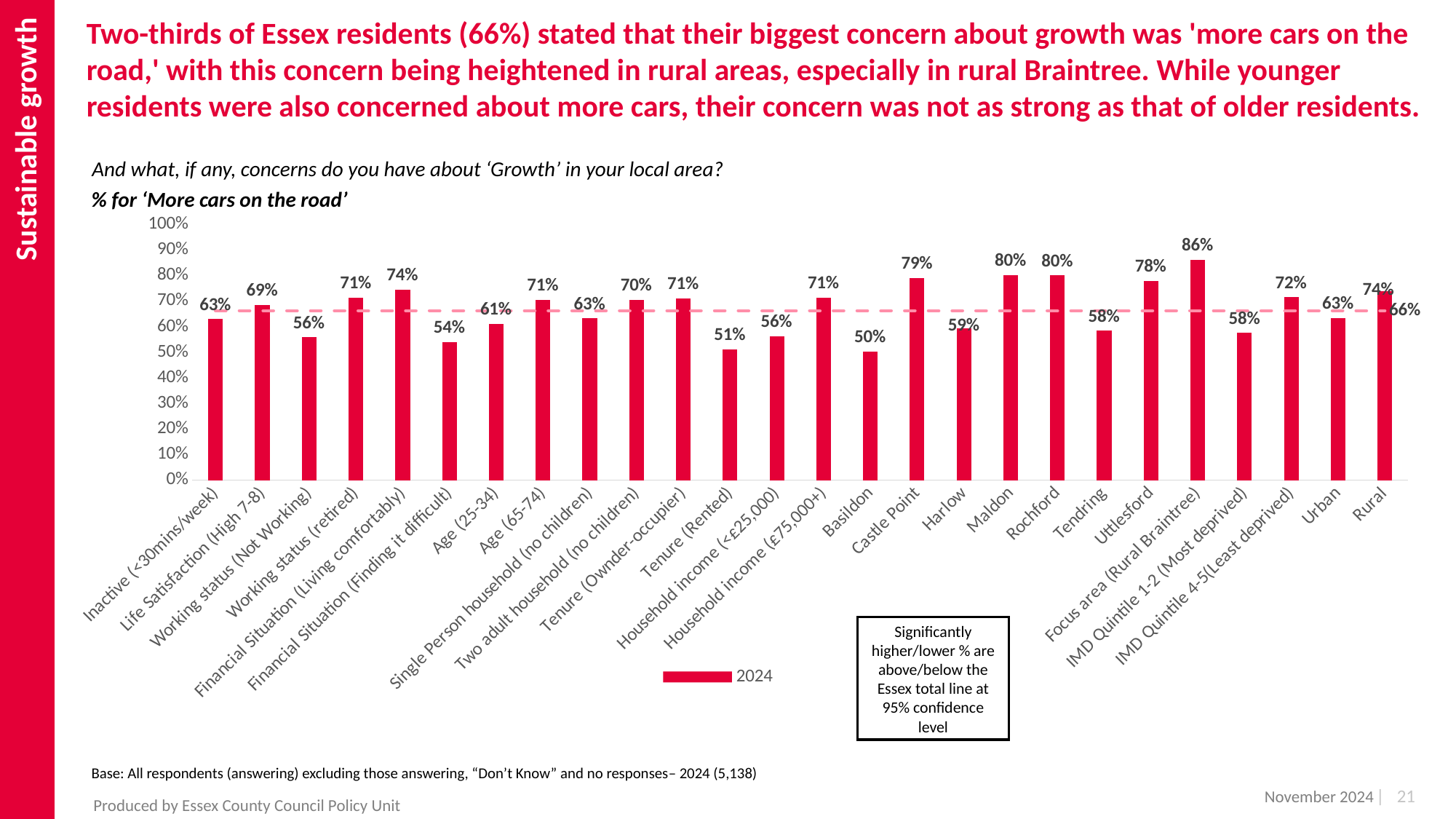
Is the value for Harlow greater or less than 70%? less What is the difference between the values for Rural and Urban? 11% How many series does the legend list? 1 Which category has the lowest value? Basildon Which is larger, the value for Age (65-74) or the value for Age (25-34)? Age (65-74) What is the value for Castle Point? 79% What kind of chart is shown on the slide? bar chart What is the value for Tenure (Rented)? 51% Which category has the highest value? Focus area (Rural Braintree) How many categories are shown on the x axis? 26 What is the value for Basildon? 50% What is the value for Focus area (Rural Braintree)? 86%